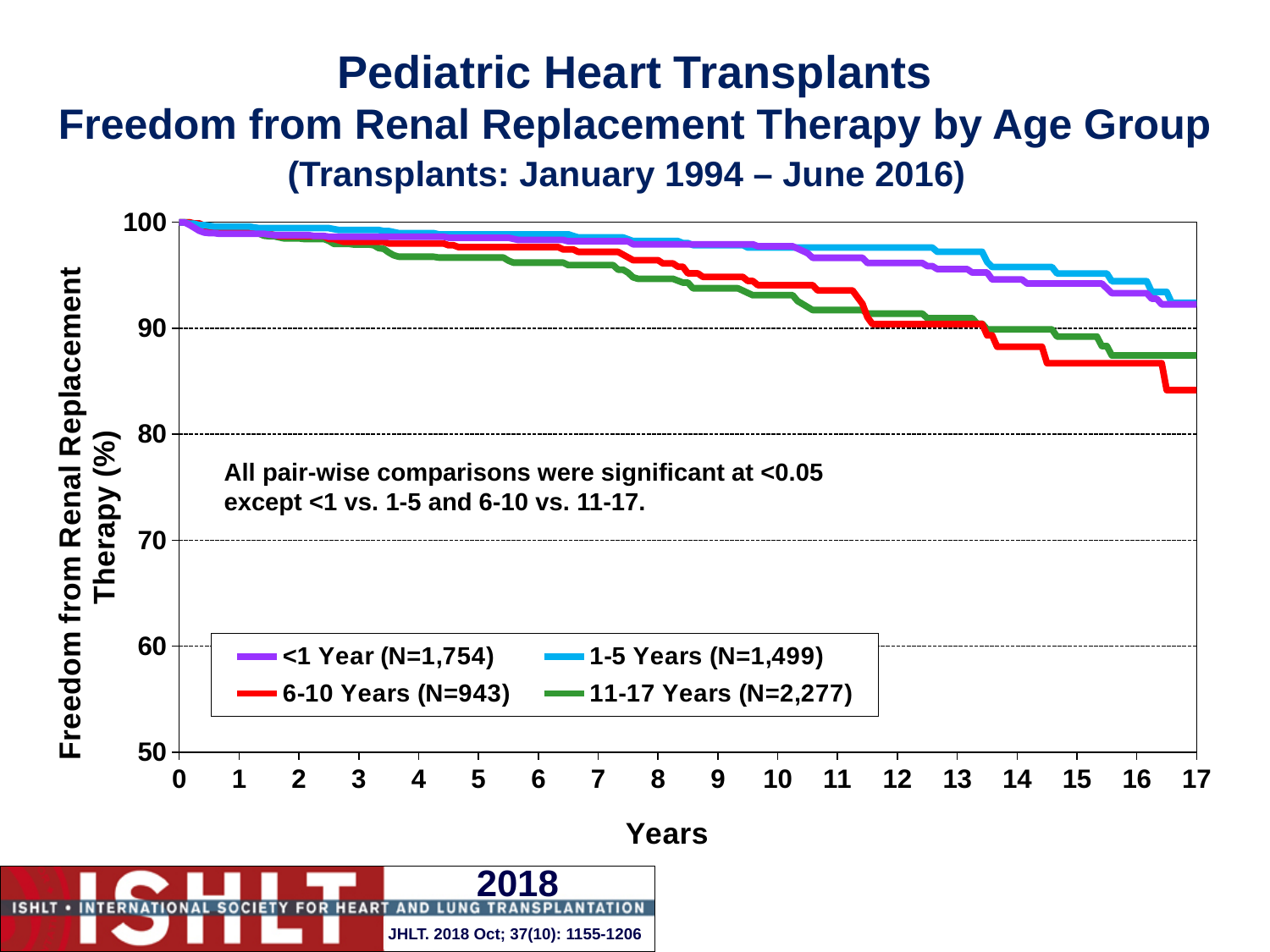
What is the N for the 6-10 Years group shown in the legend? 943 What is the value for the <1 Year group at year 0? 100 Is the value for the 6-10 Years group at year 17 greater or less than 90? less What kind of chart is shown on the slide? line chart At year 12, which is larger: the value for 1-5 Years or the value for 11-17 Years? 1-5 Years What is the N for the 11-17 Years group shown in the legend? 2,277 Is the value for the 1-5 Years group at year 17 greater or less than 90? greater Which age group has the lowest freedom from renal replacement therapy at year 17? 6-10 Years Do the values for the 6-10 Years group rise or fall as years increase? fall What is the label of the y axis? Freedom from Renal Replacement Therapy (%) Is the value for the 11-17 Years group at year 17 greater or less than 90? less How many series does the legend list? 4